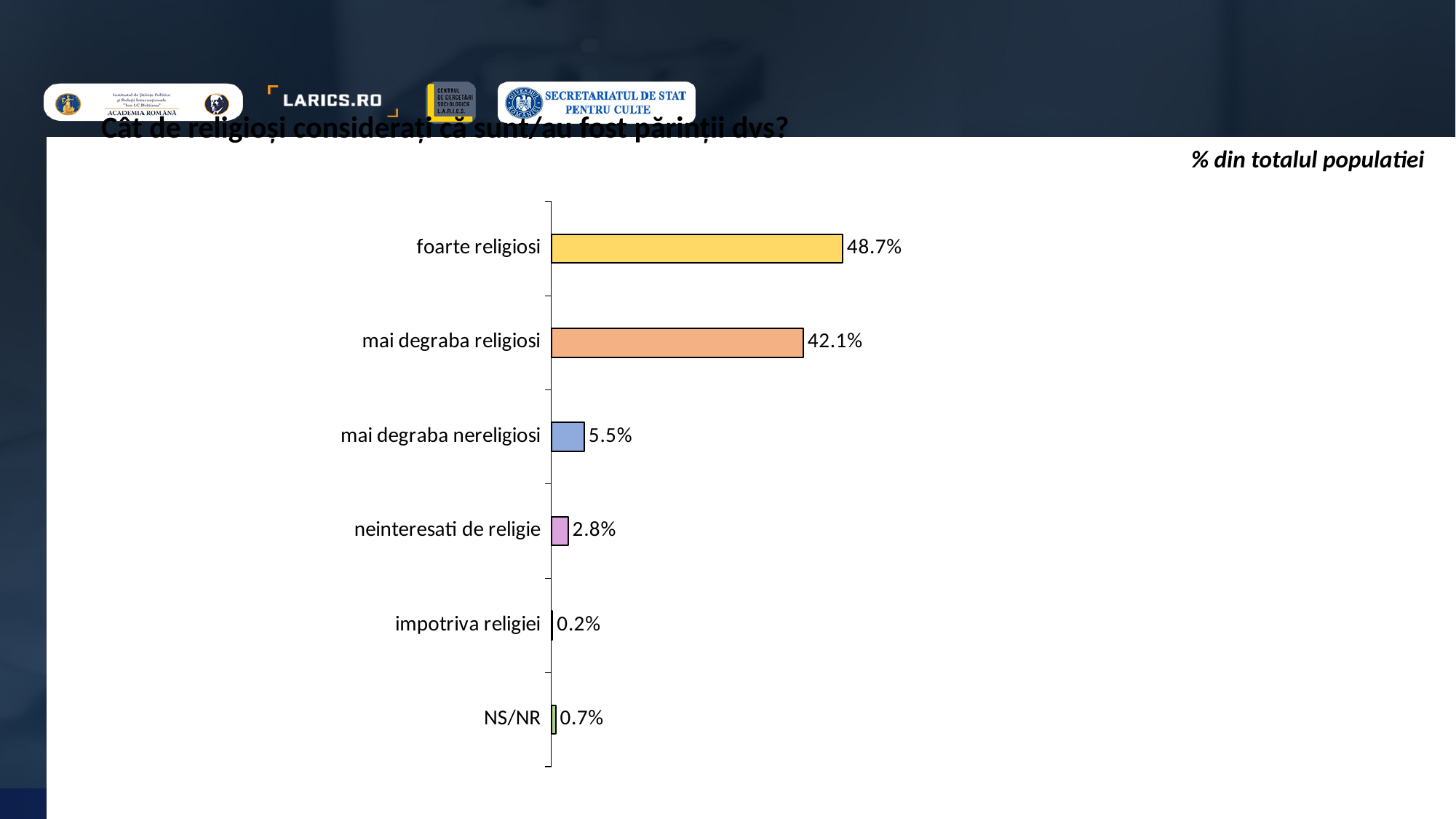
What is the value for "foarte religiosi"? 48.7% What is the value for "mai degraba nereligiosi"? 5.5% What is the value for "NS/NR"? 0.7% Which is larger, the value for "NS/NR" or the value for "impotriva religiei"? NS/NR What is the value for "neinteresati de religie"? 2.8% Which category has the lowest value? impotriva religiei What is the value for "impotriva religiei"? 0.2% Which category has the highest value? foarte religiosi What is the difference between the values for "foarte religiosi" and "mai degraba religiosi"? 6.6% What kind of chart is shown on the slide? bar chart How many categories are shown in the chart? 6 What is the value for "mai degraba religiosi"? 42.1%